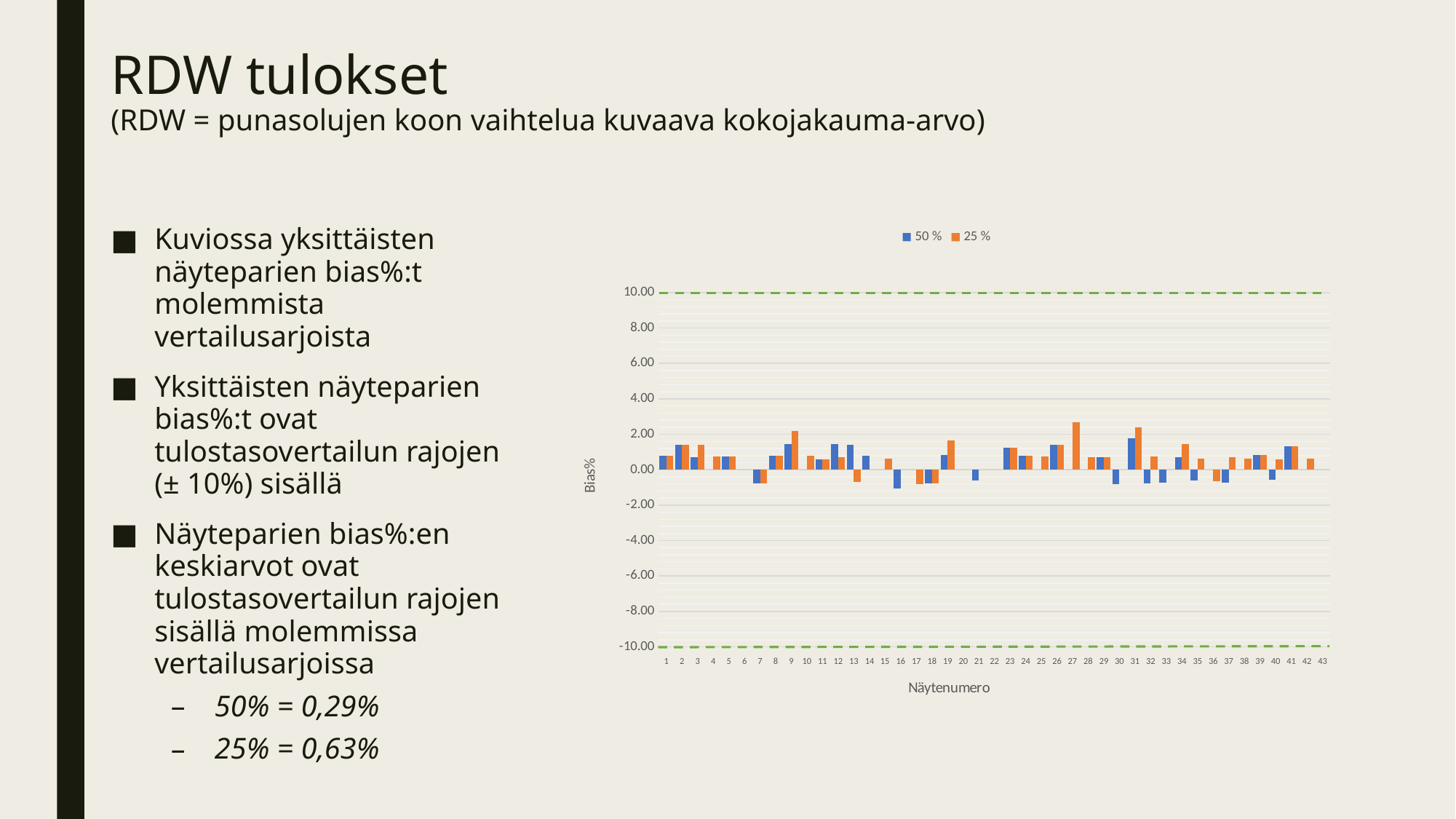
Is the 25 % series value for sample 31 greater or less than 2.00? greater Is the 50 % series value for sample 16 greater or less than 0.00? less Is the 25 % series value for sample 13 greater or less than 0.00? less Which sample number has the highest bar in the 25 % series? 27 What are the two series named in the chart legend? 50 % and 25 % How many series does the chart legend list? 2 In the 25 % series, which is larger: the value for sample 27 or the value for sample 1? sample 27 How many sample numbers (Näytenumero) are shown on the x axis of the chart? 43 What kind of chart is shown on the slide? bar chart What is the title of the y axis of the chart? Bias%